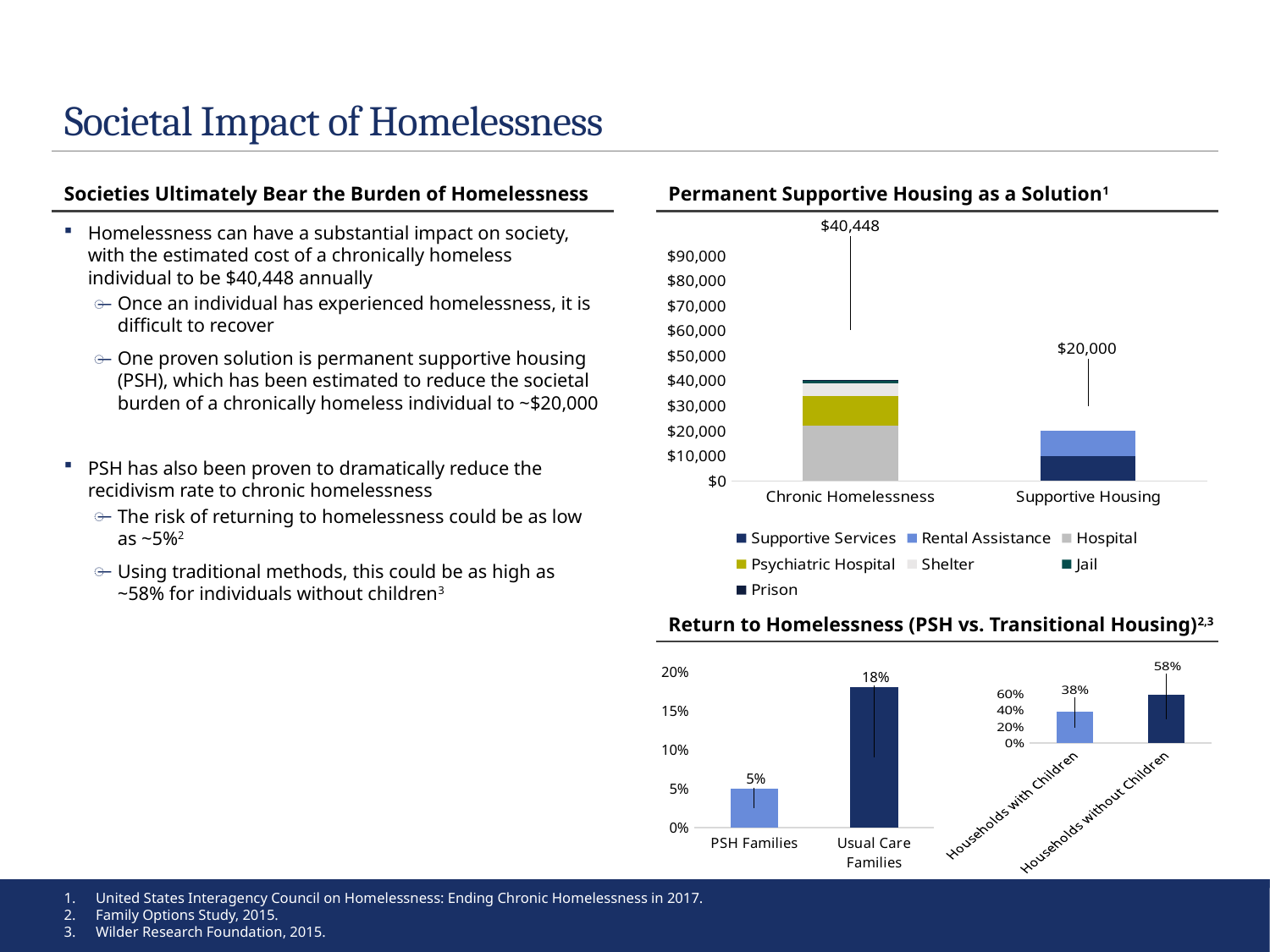
In the left 'Return to Homelessness' chart, what is the value for Usual Care Families? 18% In the 'Permanent Supportive Housing as a Solution' chart, which category has the higher labeled total? Chronic Homelessness In the 'Permanent Supportive Housing as a Solution' chart, what is the total value labeled for Chronic Homelessness? $40,448 In the 'Permanent Supportive Housing as a Solution' chart, how many series does the legend list? 7 In the right 'Return to Homelessness' chart, what is the value for Households without Children? 58% In the 'Permanent Supportive Housing as a Solution' chart, what is the difference between the labeled totals for Chronic Homelessness and Supportive Housing? $20,448 What kind of chart is 'Permanent Supportive Housing as a Solution'? Stacked bar chart In the left 'Return to Homelessness' chart, what is the difference between Usual Care Families and PSH Families? 13% In the 'Permanent Supportive Housing as a Solution' chart, what is the total value labeled for Supportive Housing? $20,000 In the 'Permanent Supportive Housing as a Solution' chart, how many categories are shown on the x axis? 2 In the left 'Return to Homelessness' chart, what is the value for PSH Families? 5% In the right 'Return to Homelessness' chart, which category has the lower value? Households with Children